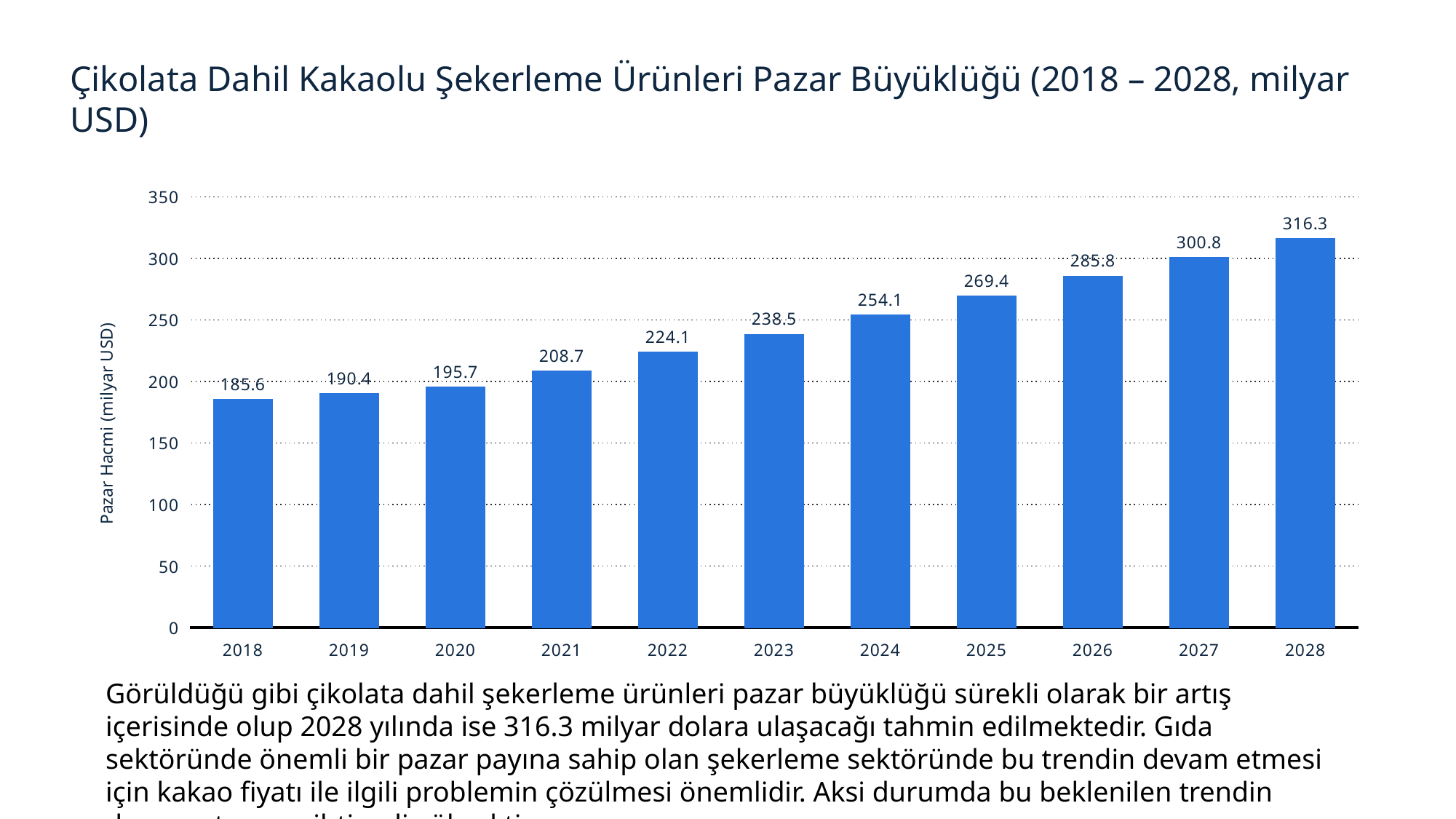
Which year has the highest market size value? 2028 What is the market size value shown for 2021? 208.7 How many years (bars) are shown in the chart? 11 What is the difference between the values for 2028 and 2018? 130.7 What is the difference between the values for 2024 and 2023? 15.6 Which year has the lowest market size value? 2018 What is the market size value shown for 2026? 285.8 What kind of chart is shown on the slide? bar chart Is the value for 2027 greater or less than 300? greater What is the market size value shown for 2018? 185.6 Do the values rise or fall from 2018 to 2028? rise Which is larger, the value for 2022 or the value for 2025? 2025